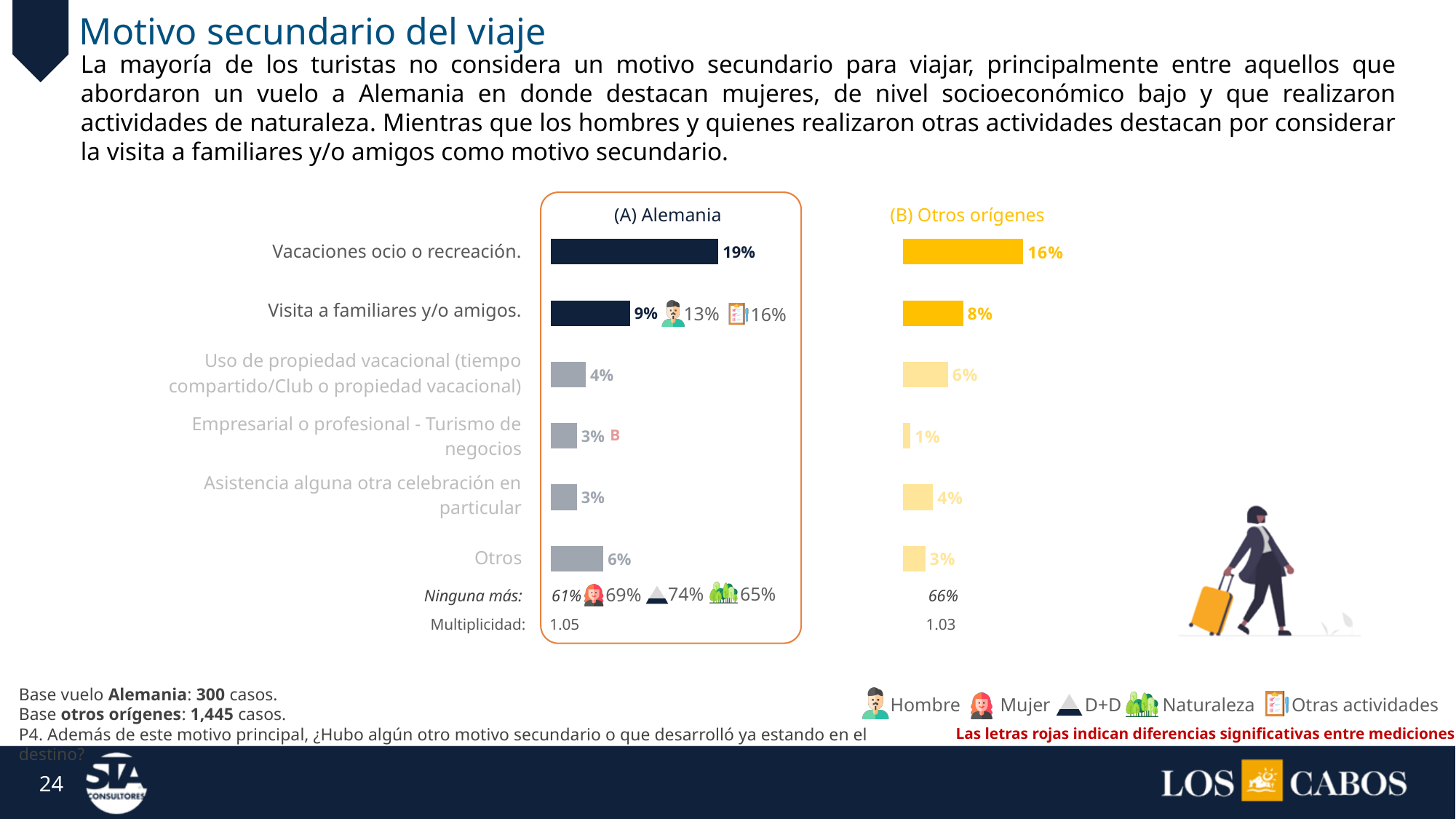
In the (B) Otros orígenes chart, which category has the lowest value? Empresarial o profesional - Turismo de negocios What is the "Ninguna más" value shown for (B) Otros orígenes? 66% How many bar categories are plotted in the (A) Alemania chart? 6 In the (A) Alemania chart, which category has the highest value? Vacaciones ocio o recreación. In the (B) Otros orígenes chart, what is the value for "Empresarial o profesional - Turismo de negocios"? 1% What type of chart is used for (A) Alemania and (B) Otros orígenes? Bar chart In the (A) Alemania chart, what is the difference between "Vacaciones ocio o recreación" and "Visita a familiares y/o amigos"? 10 percentage points What is the difference between the "Vacaciones ocio o recreación" values in the (A) Alemania chart and the (B) Otros orígenes chart? 3 percentage points What is the "Multiplicidad" value shown for (A) Alemania? 1.05 In the (A) Alemania chart, what is the value for "Vacaciones ocio o recreación"? 19% Which is larger for "Otros": the (A) Alemania value or the (B) Otros orígenes value? (A) Alemania In the (B) Otros orígenes chart, what is the value for "Visita a familiares y/o amigos"? 8%